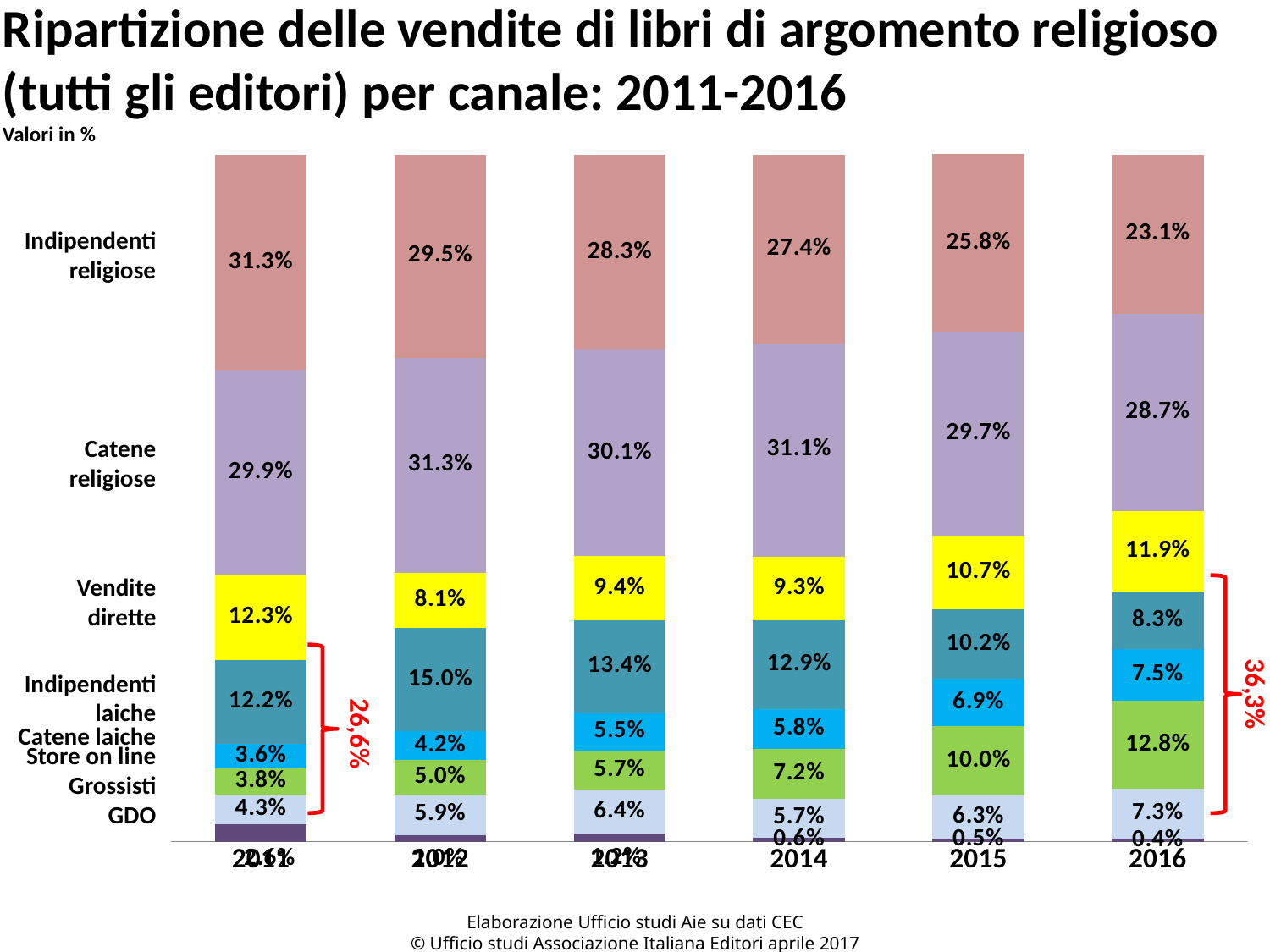
What is the value for Vendite dirette in 2016? 11.9% In which year is the Indipendenti religiose share lowest? 2016 What percentage does the red bracket annotation next to the 2016 bar show? 36,3% What is the value for Catene religiose in 2014? 31.1% What kind of chart is shown on the slide? stacked bar chart What is the value for Indipendenti religiose in 2011? 31.3% How many years (bars) are shown on the x axis? 6 In which year is the Vendite dirette share highest? 2011 What is the value of the smallest (bottom) segment of the 2015 bar? 0.5% What is the difference between the Indipendenti religiose value in 2011 and in 2016? 8.2% Which is larger in 2012: Catene religiose or Indipendenti religiose? Catene religiose Does the Indipendenti religiose share rise or fall from 2011 to 2016? fall